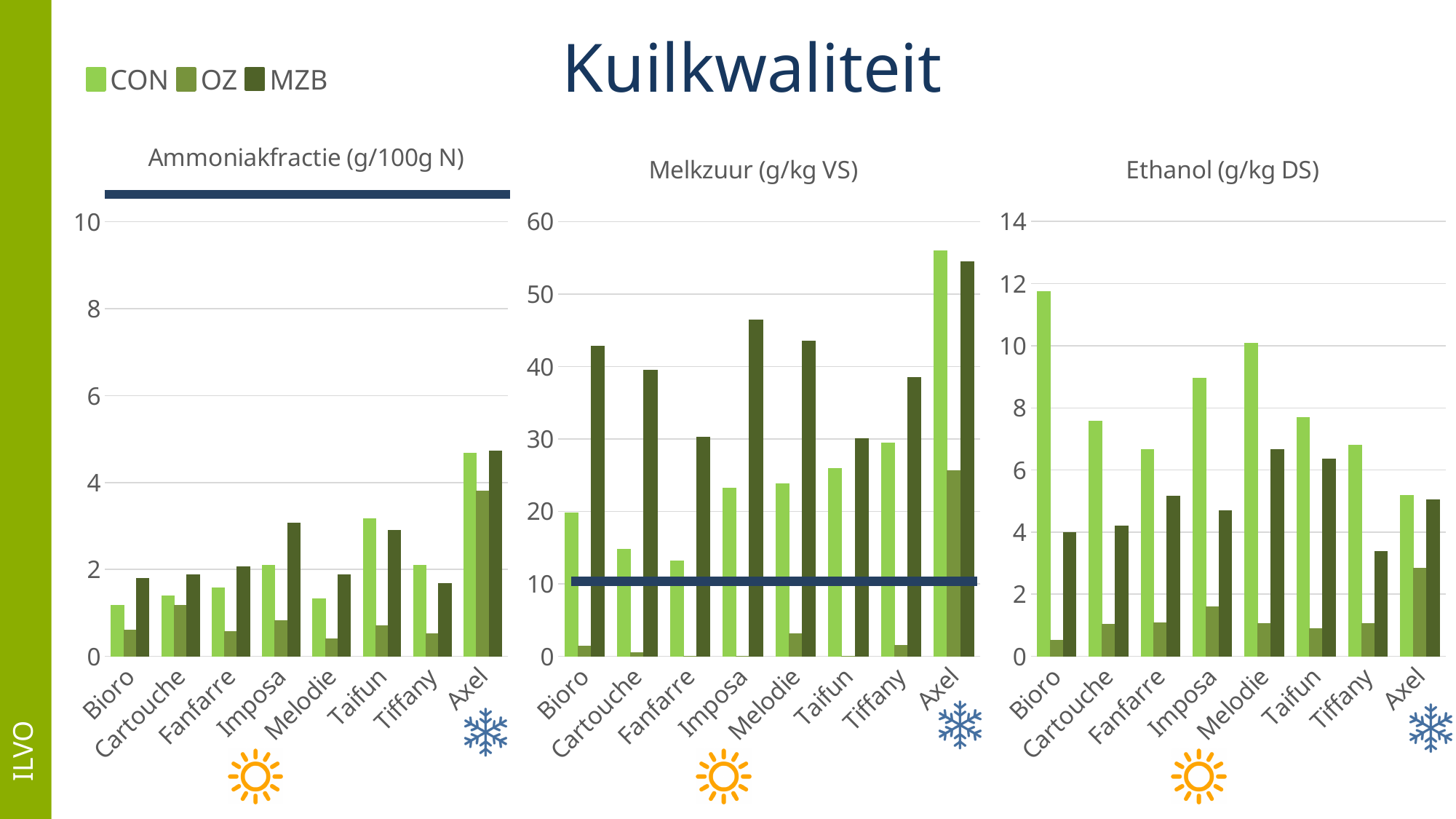
In the Ethanol (g/kg DS) chart, which is larger for Taifun: the CON value or the MZB value? CON What are the three legend entries shown on the slide? CON, OZ, MZB In the Melkzuur (g/kg VS) chart, is the MZB value for Bioro greater or less than 40? greater In the Ethanol (g/kg DS) chart, which category has the highest CON value? Bioro In the Ammoniakfractie (g/100g N) chart, is the CON value for Taifun greater or less than 2? greater In the Ethanol (g/kg DS) chart, is the MZB value for Tiffany greater or less than 4? less How many categories are shown on the x axis of the Ethanol (g/kg DS) chart? 8 In the Melkzuur (g/kg VS) chart, which category has the highest MZB value? Axel In the Melkzuur (g/kg VS) chart, which is larger for Imposa: the CON value or the MZB value? MZB In the Ammoniakfractie (g/100g N) chart, which category has the highest CON value? Axel What kind of chart is the Melkzuur (g/kg VS) chart? bar chart How many series does the legend list for the charts on this slide? 3